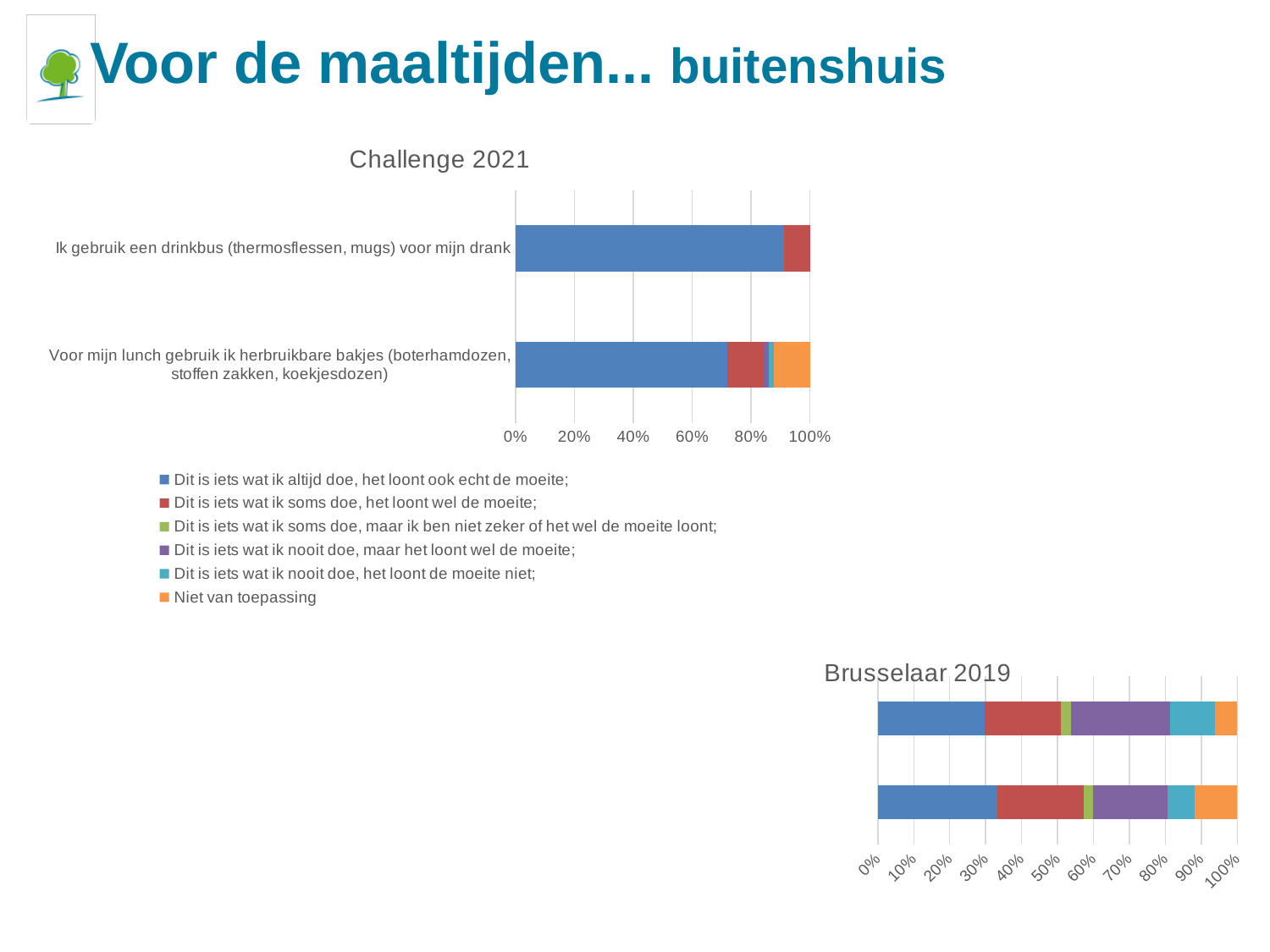
On the 'Challenge 2021' chart, which category has the larger share of 'Dit is iets wat ik altijd doe, het loont ook echt de moeite;'? Ik gebruik een drinkbus (thermosflessen, mugs) voor mijn drank On the 'Challenge 2021' chart, is the share of 'Dit is iets wat ik altijd doe, het loont ook echt de moeite;' for 'Voor mijn lunch gebruik ik herbruikbare bakjes (boterhamdozen, stoffen zakken, koekjesdozen)' greater or less than 80%? less Which colour represents 'Niet van toepassing' in the legend of the 'Challenge 2021' chart? orange On the 'Challenge 2021' chart, which category has the larger 'Niet van toepassing' segment? Voor mijn lunch gebruik ik herbruikbare bakjes (boterhamdozen, stoffen zakken, koekjesdozen) On the 'Challenge 2021' chart, is the share of 'Dit is iets wat ik altijd doe, het loont ook echt de moeite;' for 'Voor mijn lunch gebruik ik herbruikbare bakjes (boterhamdozen, stoffen zakken, koekjesdozen)' greater or less than 60%? greater What kind of chart is the 'Challenge 2021' chart? stacked bar chart What is the title of the chart at the bottom right of the slide? Brusselaar 2019 How many categories are shown on the 'Challenge 2021' chart? 2 How many bars are shown on the 'Brusselaar 2019' chart? 2 On the 'Brusselaar 2019' chart, is the blue segment of the top bar greater or less than 40%? less How many series does the legend of the 'Challenge 2021' chart list? 6